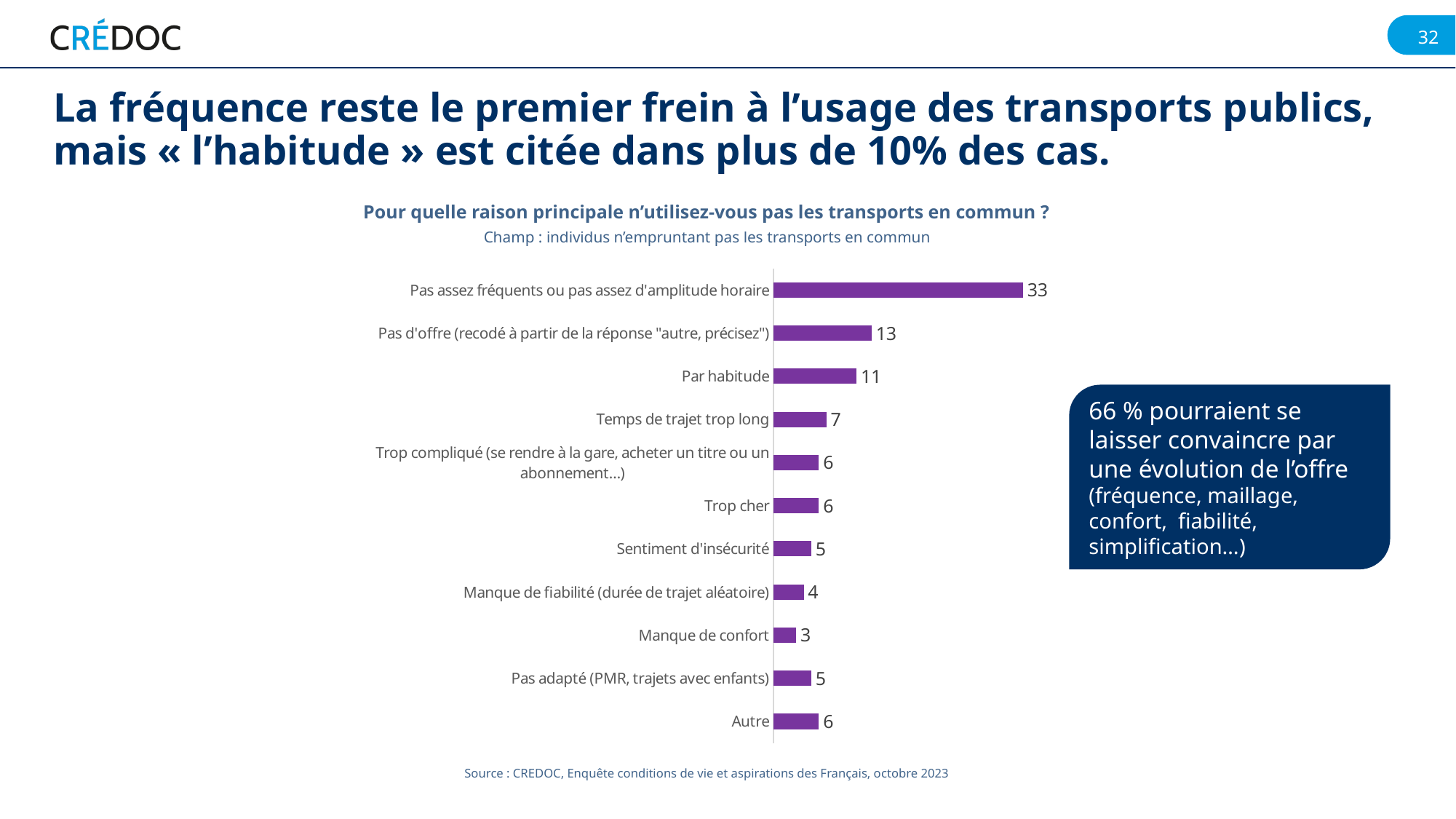
What is the difference between "Par habitude" and "Trop cher"? 5 How many categories are shown in the chart? 11 What is the value for "Manque de confort"? 3 What kind of chart is shown on the slide? Bar chart What is the value for "Par habitude"? 11 Which is larger, "Sentiment d'insécurité" or "Manque de fiabilité (durée de trajet aléatoire)"? Sentiment d'insécurité What is the value for "Temps de trajet trop long"? 7 Which category has the lowest value? Manque de confort What is the title of the chart? Pour quelle raison principale n'utilisez-vous pas les transports en commun ? What is the difference between "Pas assez fréquents ou pas assez d'amplitude horaire" and "Pas d'offre (recodé à partir de la réponse "autre, précisez")"? 20 Which category has the highest value? Pas assez fréquents ou pas assez d'amplitude horaire What is the value for "Pas assez fréquents ou pas assez d'amplitude horaire"? 33